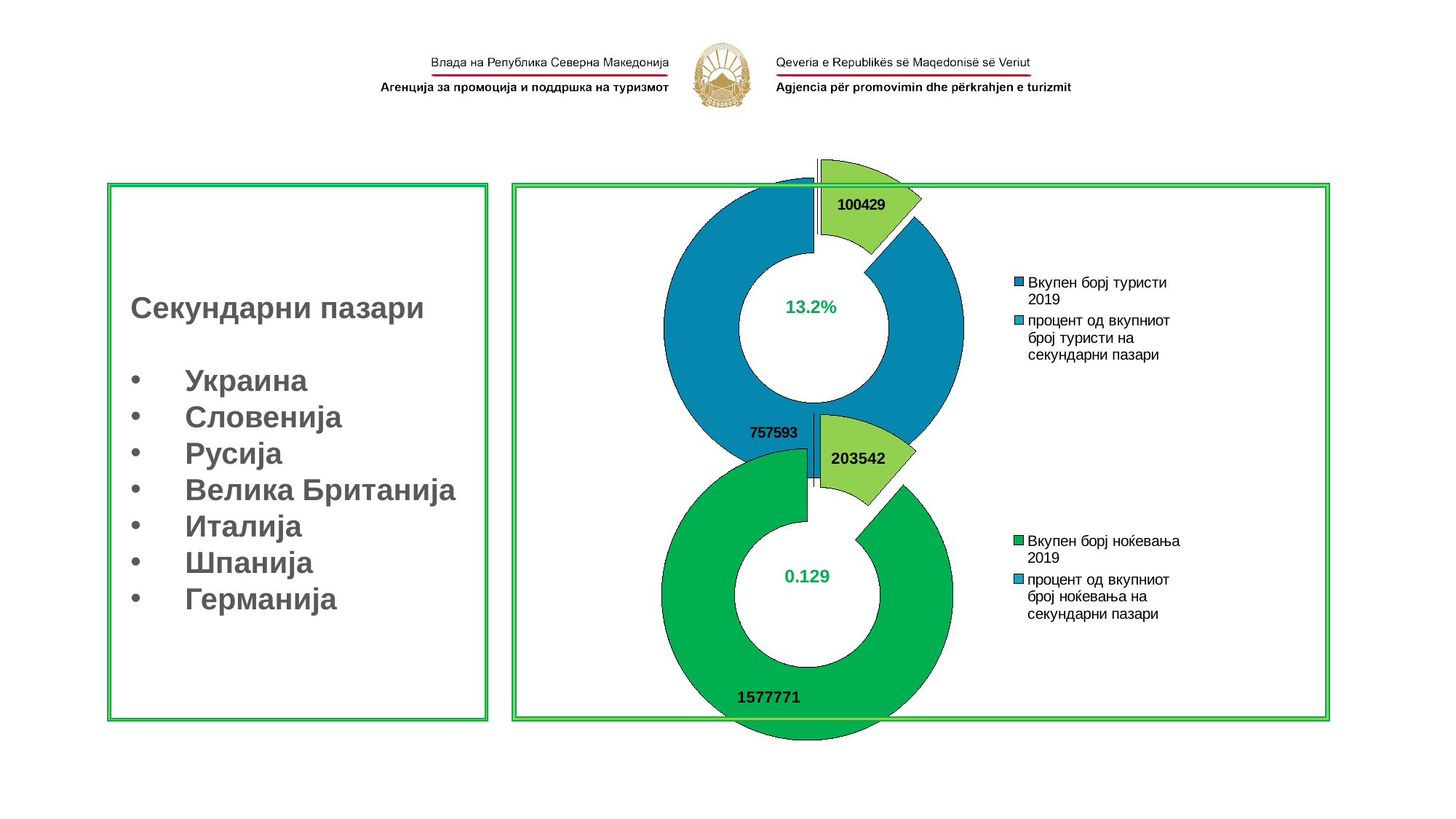
In the top chart, what value is shown for 'Вкупен борј туристи 2019'? 757593 What percentage is printed in the centre of the top chart? 13.2% In the bottom chart, what is the difference between 1577771 and 203542? 1374229 In the bottom chart, which segment is the smallest? процент од вкупниот број ноќевања на секундарни пазари In the top chart, which segment is larger: 'Вкупен борј туристи 2019' or 'процент од вкупниот број туристи на секундарни пазари'? Вкупен борј туристи 2019 In the top chart, what is the difference between 757593 and 100429? 657164 What type of chart is the top chart? Doughnut chart How many entries does the legend of the bottom chart list? 2 What value is printed in the centre of the bottom chart? 0.129 In the bottom chart, what value is shown for 'процент од вкупниот број ноќевања на секундарни пазари'? 0.129 In the bottom chart, what value is shown for 'Вкупен борј ноќевања 2019'? 1577771 In the top chart, what value is shown for 'процент од вкупниот број туристи на секундарни пазари'? 13.2%